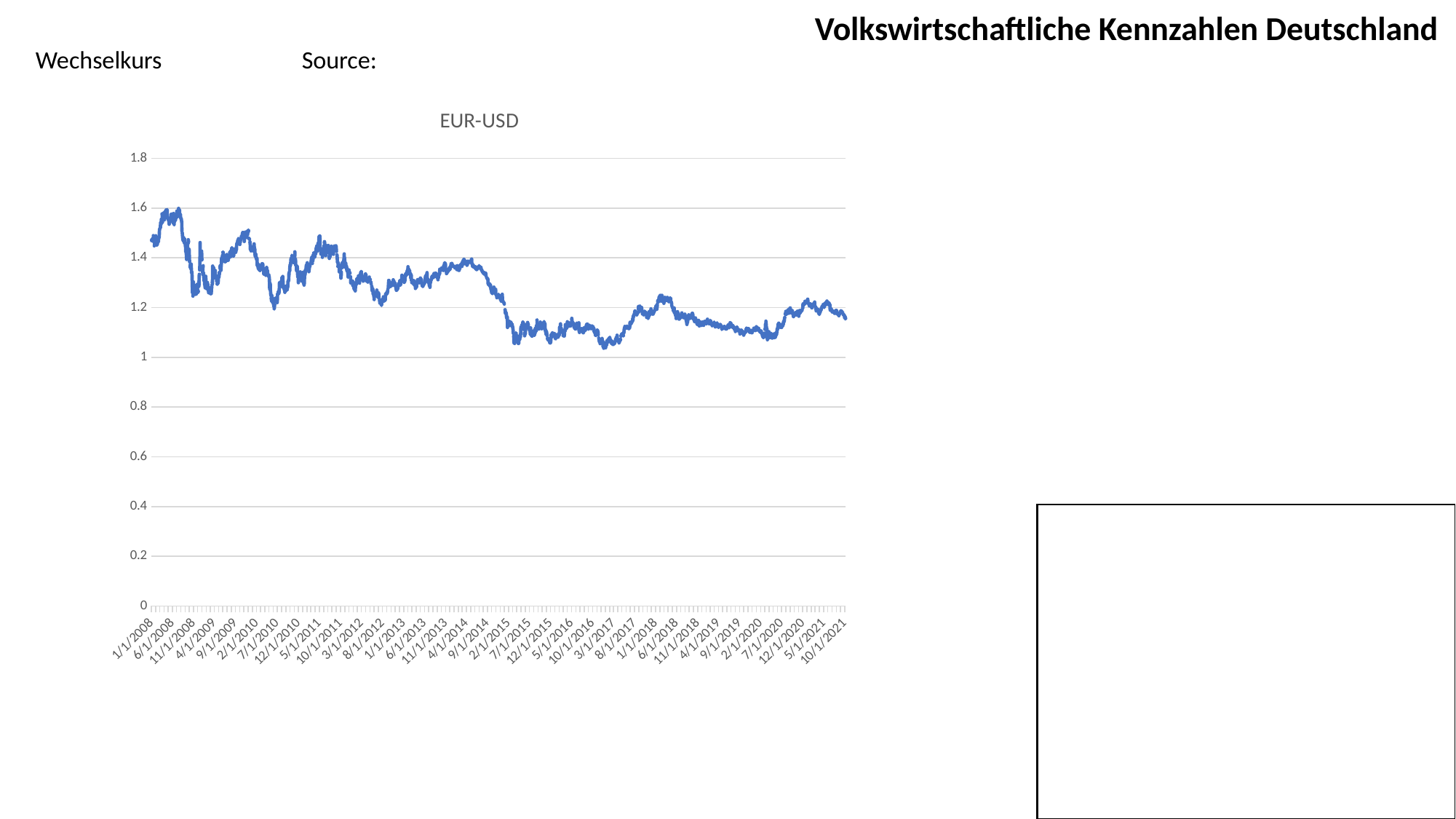
Overall, does the EUR-USD rate rise or fall from 1/1/2008 to 10/1/2021? fall Is the EUR-USD value at 1/1/2008 greater or less than 1.4? greater How many data series are plotted in the EUR-USD chart? 1 What is the highest value shown on the y axis of the EUR-USD chart? 1.8 Is the EUR-USD value at 10/1/2021 greater or less than 1.2? less Is the EUR-USD value at 3/1/2017 greater or less than 1.2? less What kind of chart is shown on the slide? line chart What is the title of the chart? EUR-USD Which is larger: the EUR-USD value at 1/1/2008 or at 3/1/2017? 1/1/2008 Which is larger: the EUR-USD value at 6/1/2008 or at 10/1/2021? 6/1/2008